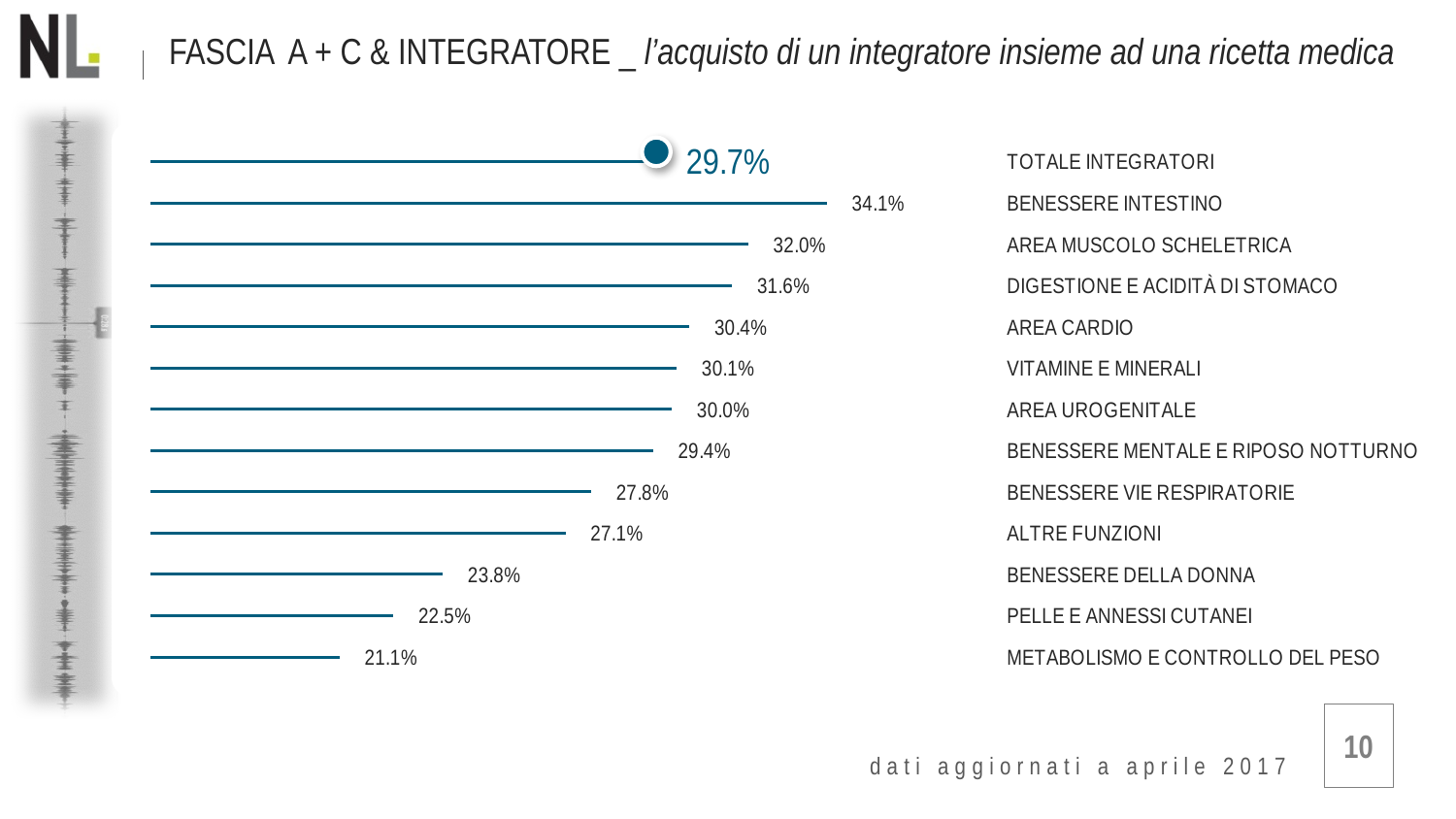
Which category has the lowest value? METABOLISMO E CONTROLLO DEL PESO Which category has the highest value? BENESSERE INTESTINO Which category is marked with a circle at the end of its bar? TOTALE INTEGRATORI What is the value for TOTALE INTEGRATORI? 29.7% How many categories are shown in the chart? 13 What is the value for PELLE E ANNESSI CUTANEI? 22.5% What kind of chart is shown on the slide? bar chart What is the value for BENESSERE INTESTINO? 34.1% What is the difference between the values for AREA MUSCOLO SCHELETRICA and TOTALE INTEGRATORI? 2.3% What is the value for AREA CARDIO? 30.4% What is the difference between the values for BENESSERE INTESTINO and METABOLISMO E CONTROLLO DEL PESO? 13.0% Which is larger, the value for BENESSERE DELLA DONNA or the value for ALTRE FUNZIONI? ALTRE FUNZIONI